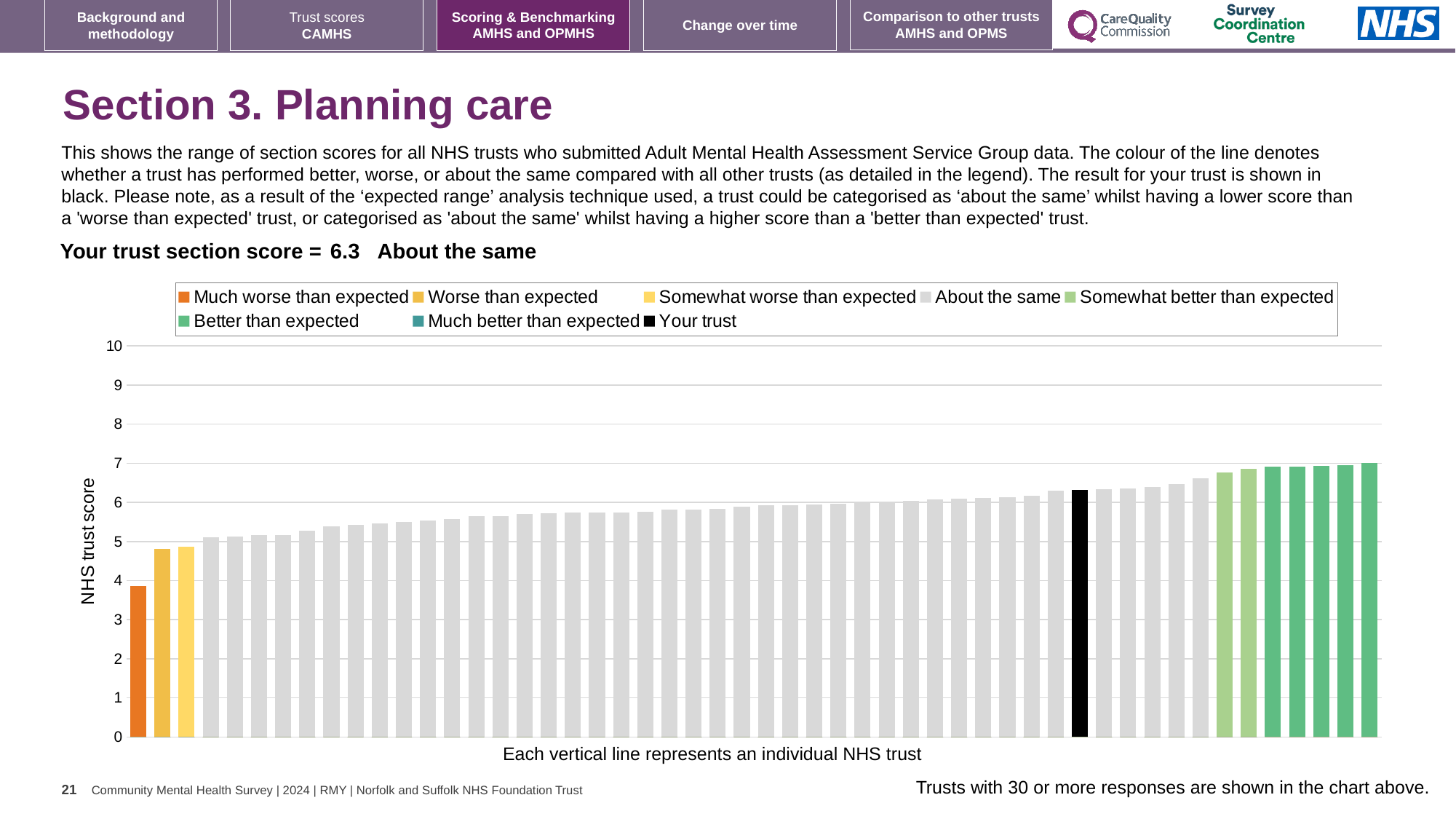
How many bars are coloured orange ('Much worse than expected')? 1 Is the value of the lowest bar (the orange 'Much worse than expected' bar) greater or less than 5? less Is the value of the tallest bar in the chart greater or less than 8? less Do the bar values rise or fall from left to right along the x axis? rise What is the section score for your trust shown on the slide? 6.3 What colour is used for the 'Your trust' bar according to the legend? black What is the label on the vertical axis of the chart? NHS trust score Which legend category does the lowest bar in the chart belong to? Much worse than expected Which legend category does the tallest bar in the chart belong to? Better than expected Is the value of the black 'Your trust' bar greater or less than 6? greater What kind of chart is shown on the slide? bar chart How many entries does the chart legend list? 8